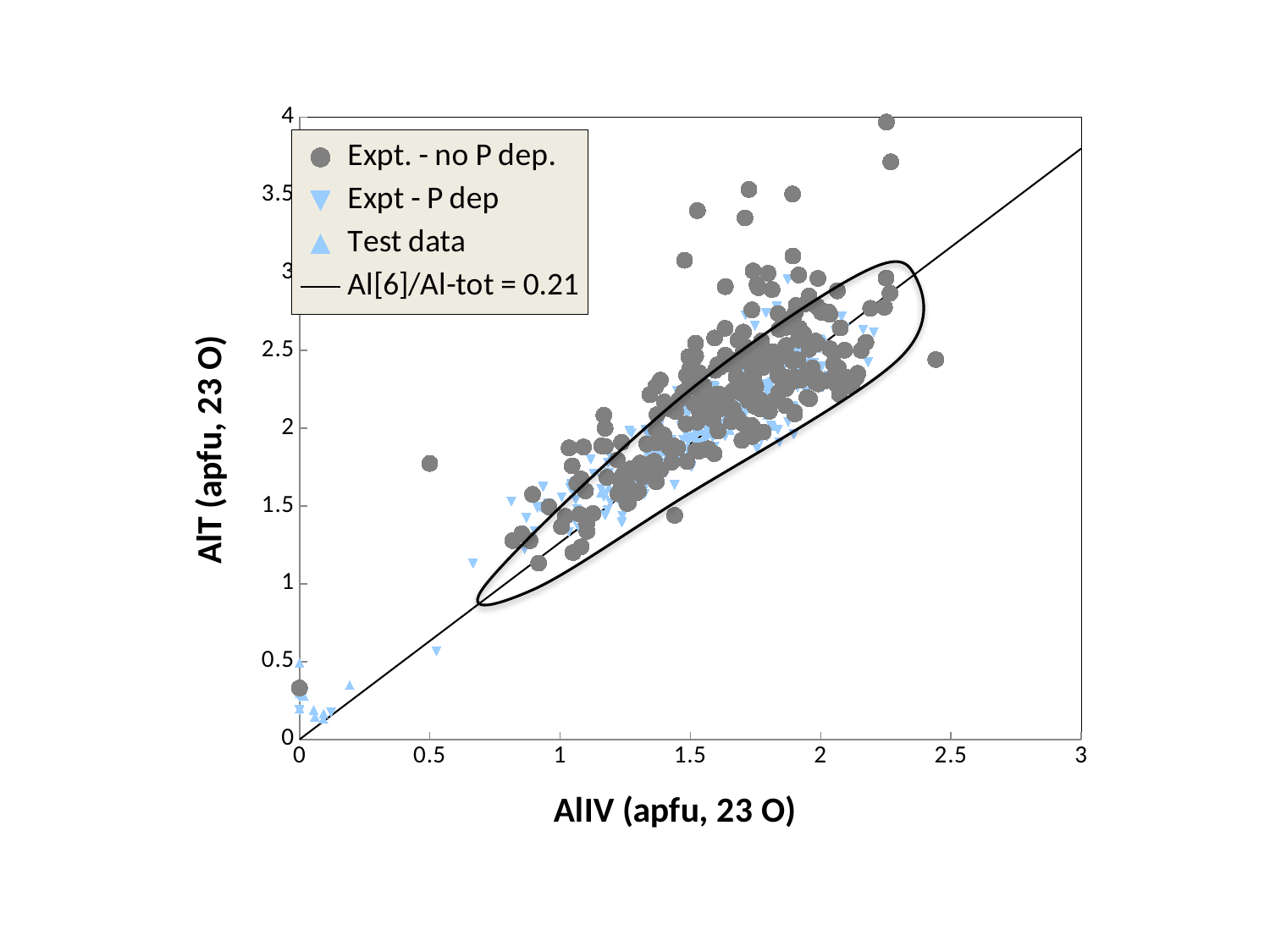
Do the AlT values generally rise or fall as AlIV increases along the x axis? rise What legend label is given to the straight line in the chart? Al[6]/Al-tot = 0.21 What kind of chart is shown on the slide? scatter chart Is the AlT value of the isolated grey circle at AlIV = 0.5 greater or less than 1.5? greater How many entries does the legend list? 4 What is the title of the x axis? AlIV (apfu, 23 O) Is the AlT value of the highest grey circle greater or less than 3.5? greater